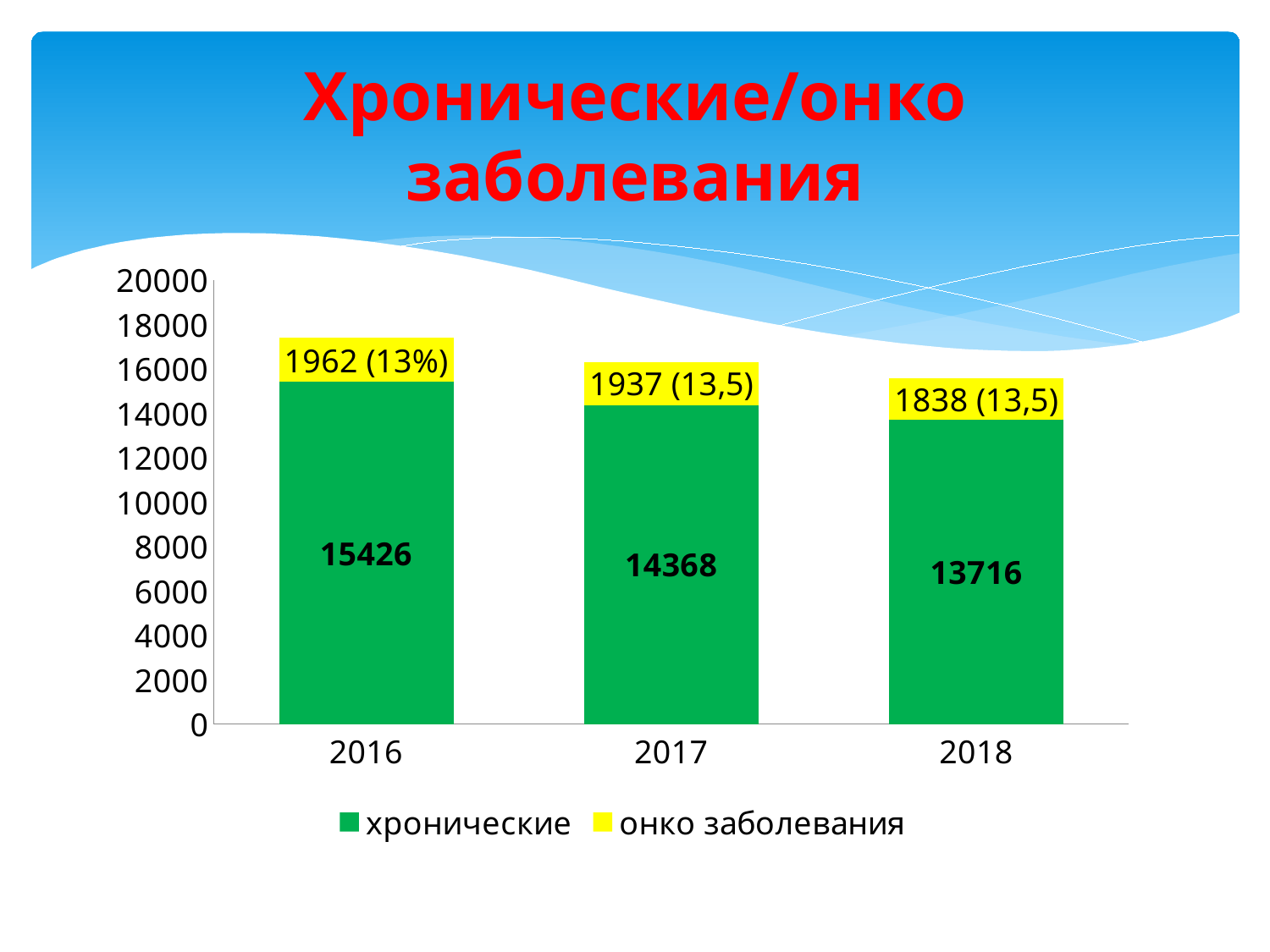
Which year has the highest value for хронические? 2016 Do the хронические values rise or fall from 2016 to 2018? Fall What is the value for хронические in 2018? 13716 What is the data label for онко заболевания in 2017? 1937 (13,5) What is the value for хронические in 2016? 15426 What type of chart is shown on the slide? Stacked bar chart What is the difference between the хронические values for 2016 and 2018? 1710 Is the хронические value for 2017 larger than the хронические value for 2018? Yes Which year has the lowest value for онко заболевания? 2018 How many series does the legend list? 2 How many years are shown on the x axis? 3 What is the data label for онко заболевания in 2016? 1962 (13%)